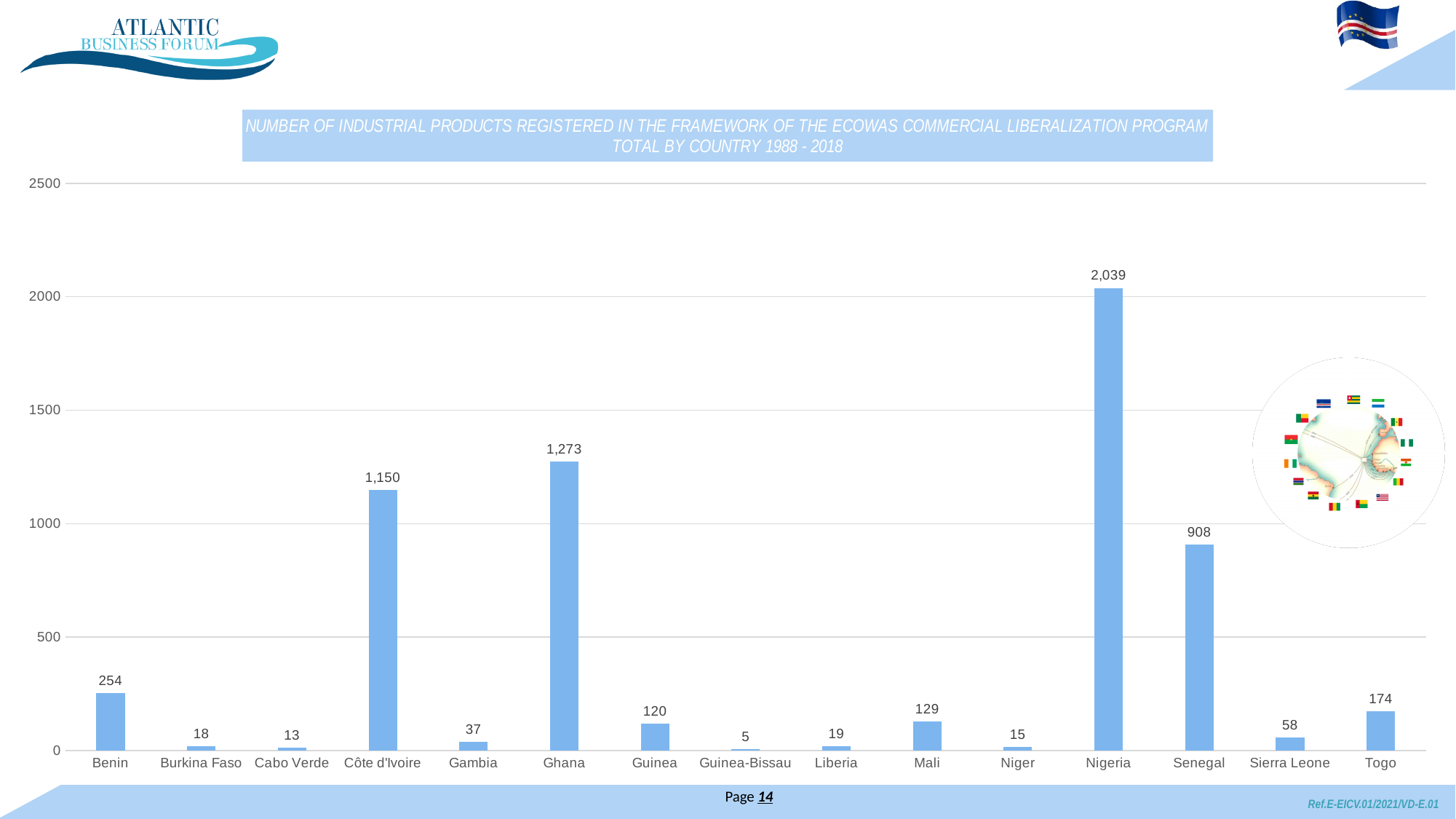
Is the value for Senegal greater or less than 1000? less How many countries are shown on the x axis? 15 Which country has the highest number of registered industrial products? Nigeria What is the value for Cabo Verde? 13 Which country has the lowest number of registered industrial products? Guinea-Bissau What is the value for Nigeria? 2,039 What kind of chart is shown on the slide? bar chart What is the difference between the values for Ghana and Côte d'Ivoire? 123 What period does the chart title say the totals cover? 1988 - 2018 What is the value for Senegal? 908 Which is larger, the value for Benin or the value for Togo? Benin What is the difference between the values for Mali and Guinea? 9